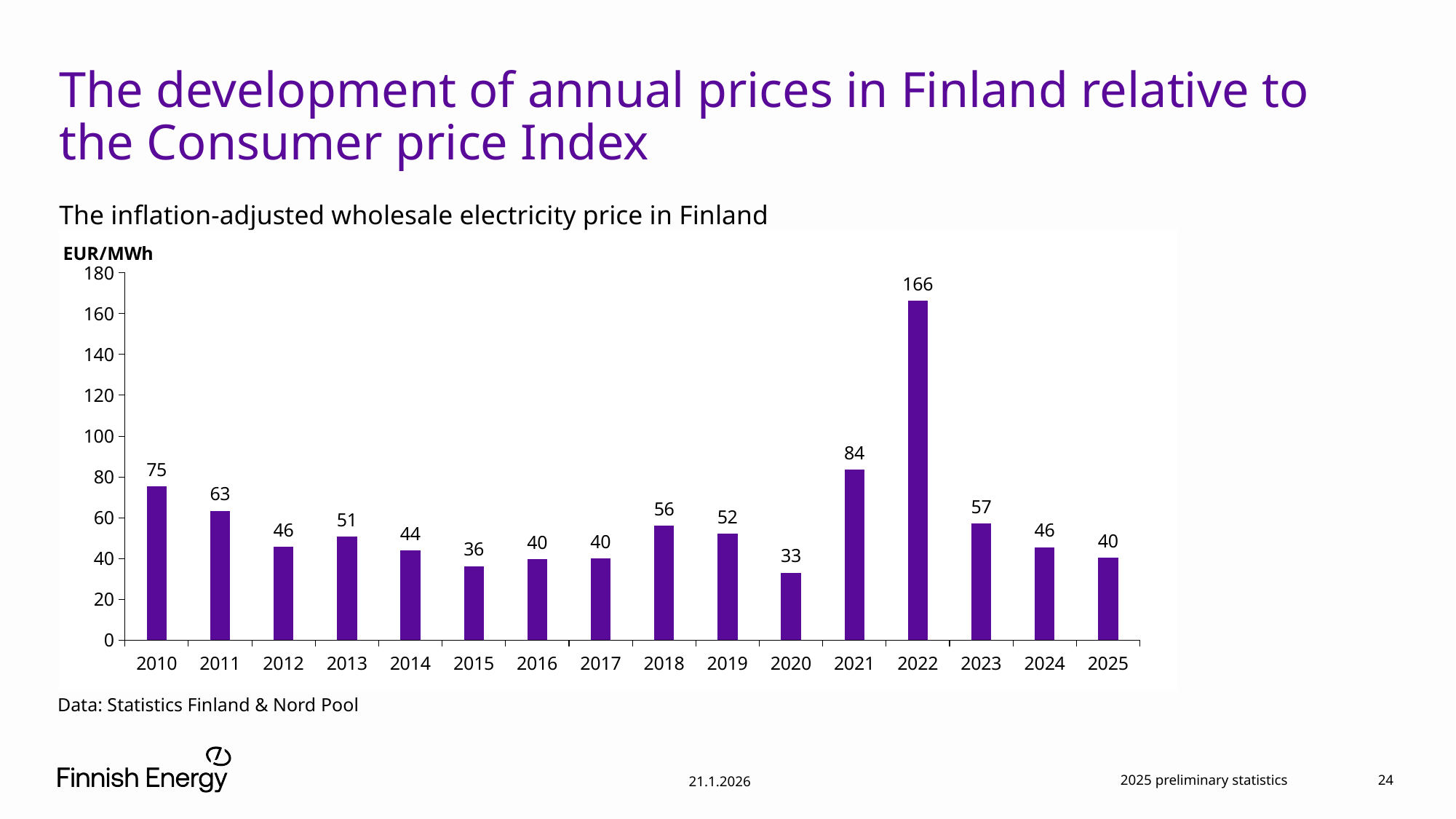
What is the difference between the values for 2010 and 2011? 12 What kind of chart is shown on the slide? Bar chart Which year has a higher value, 2018 or 2019? 2018 How many years are shown on the x axis? 16 Is the value for 2021 greater or less than 80? greater What is the difference between the values for 2022 and 2021? 82 What is the inflation-adjusted wholesale electricity price for 2022? 166 What unit is shown on the chart's vertical axis? EUR/MWh What is the value shown for 2025? 40 What is the value shown for 2010? 75 Which year has the lowest inflation-adjusted wholesale electricity price? 2020 Which year has the highest inflation-adjusted wholesale electricity price? 2022